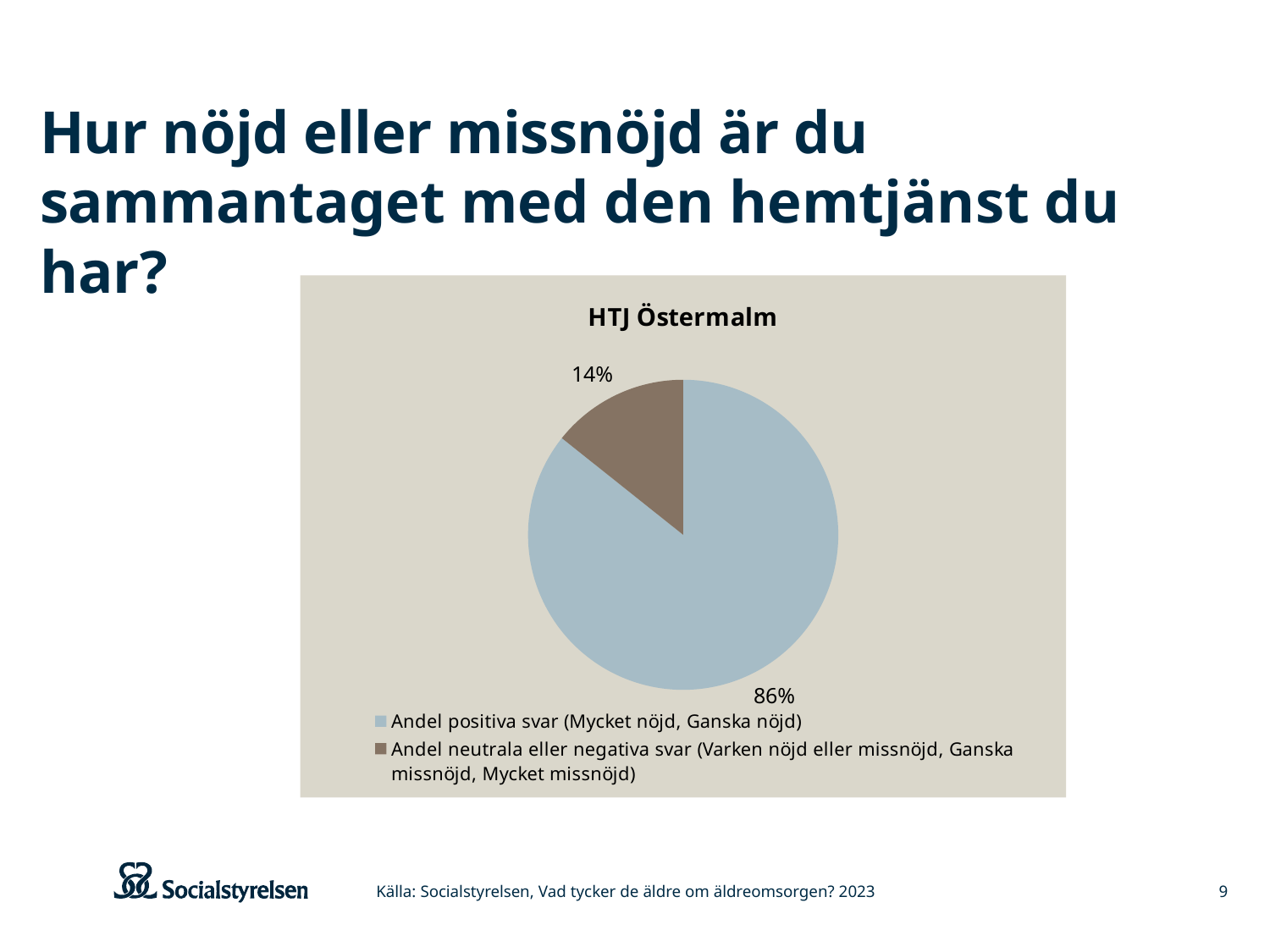
What is the difference in percentage points between the positive slice and the neutral/negative slice? 72 percentage points Which slice is the smallest? Andel neutrala eller negativa svar (Varken nöjd eller missnöjd, Ganska missnöjd, Mycket missnöjd) What colour is the slice for 'Andel positiva svar'? light blue-grey How many entries does the legend list? 2 Which is larger: the share of positive answers or the share of neutral or negative answers? positive answers Which slice is the largest? Andel positiva svar (Mycket nöjd, Ganska nöjd) How many slices does the pie chart have? 2 What is the total of the two slices shown? 100% What kind of chart is shown on the slide? pie chart What share of responses is 'Andel neutrala eller negativa svar'? 14% What share of responses is 'Andel positiva svar (Mycket nöjd, Ganska nöjd)'? 86% What is the chart's title? HTJ Östermalm